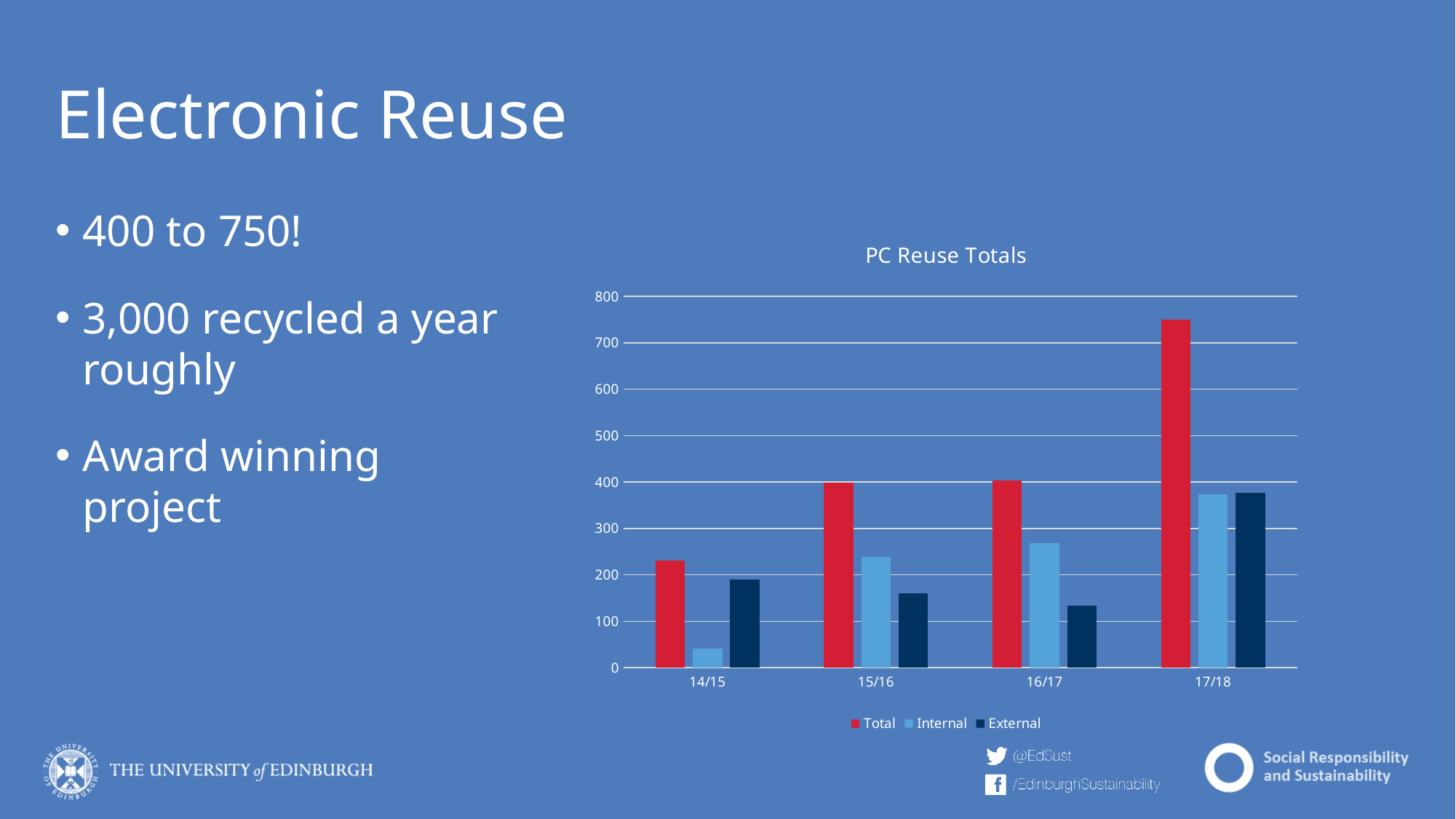
Is the Internal value for 14/15 greater or less than 100? less How many series does the legend of the chart list? 3 Which year has the lowest External value? 16/17 Which year has the highest Total value? 17/18 Which year has the lowest Internal value? 14/15 What is the title of the chart? PC Reuse Totals Is the Total value for 17/18 greater or less than 700? greater How many years are shown on the x axis of the chart? 4 Is the External value for 16/17 greater or less than 200? less In 14/15, which is larger, the Internal value or the External value? External Does the Total value rise or fall from 14/15 to 17/18? rise What kind of chart is shown on the slide? bar chart